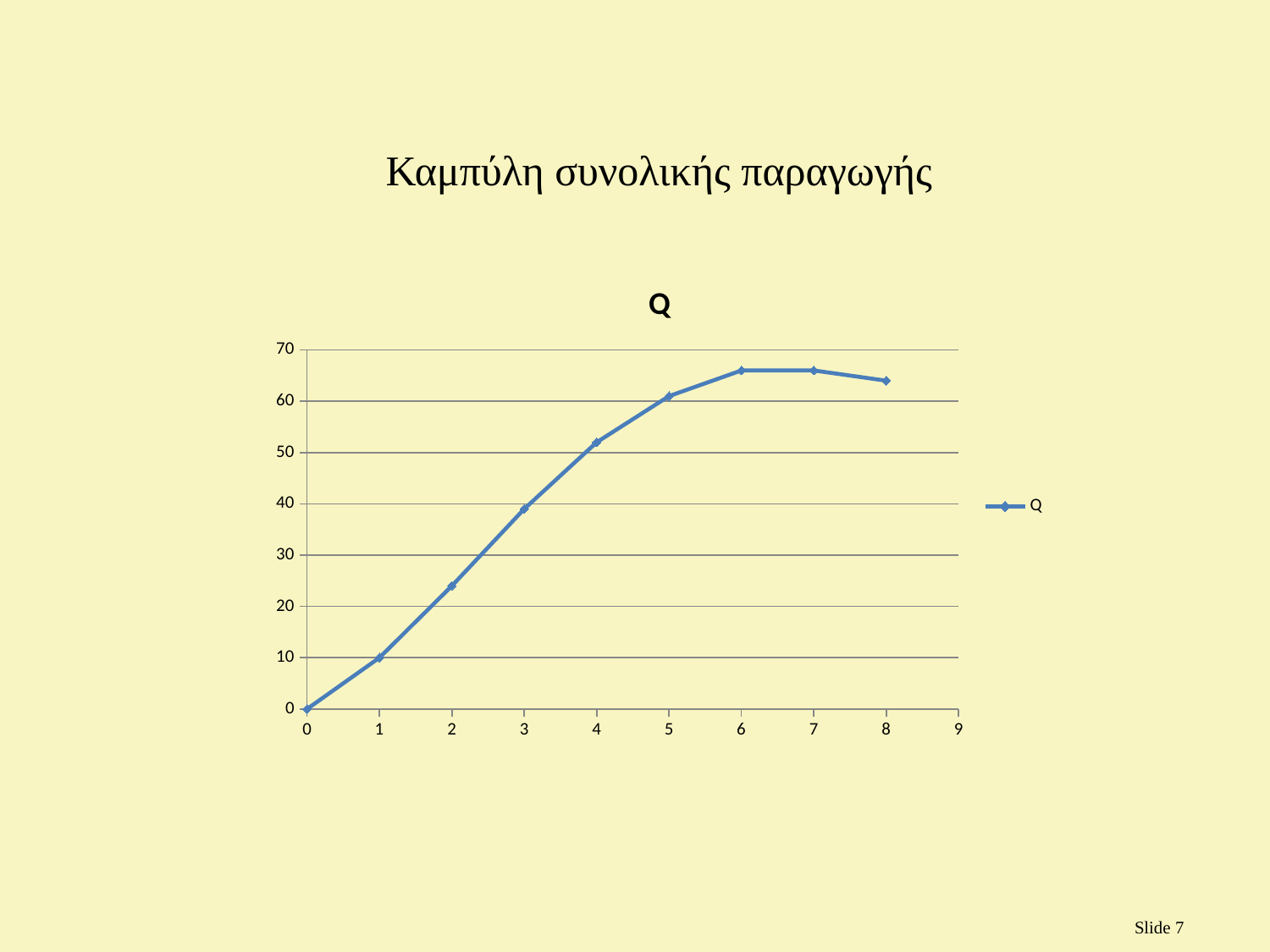
What is the value of Q at x = 1? 10 What is the value of Q at x = 0? 0 Which has the larger value of Q: x = 2 or x = 4? x = 4 At which x value is Q lowest? 0 Is the value of Q at x = 6 greater or less than 70? less How many series does the legend list? 1 What is the title of the chart? Q Does Q rise or fall between x = 0 and x = 5? rise What kind of chart is shown on the slide? line chart How many data points are plotted on the line? 9 Is the value of Q at x = 2 greater or less than 20? greater Is the value of Q at x = 4 greater or less than 50? greater